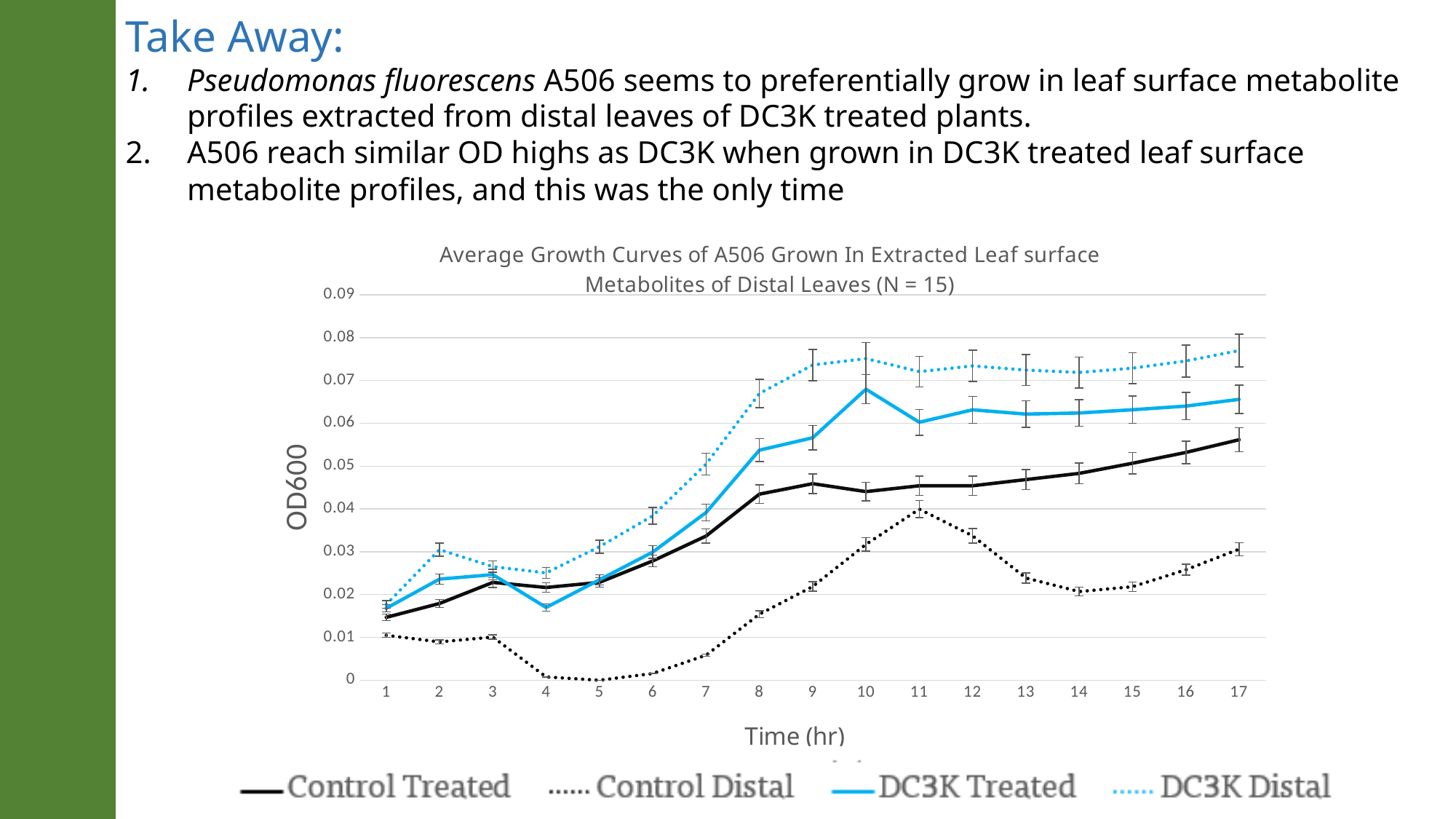
Is the value for Control Distal at hour 5 greater or less than 0.01? less Is the value for Control Treated at hour 17 greater or less than 0.05? greater Is the value for DC3K Distal at hour 10 greater or less than 0.07? greater How many series does the legend list? 4 What is the label of the x axis? Time (hr) Does the Control Distal series rise or fall from hour 11 to hour 14? fall How many time points are plotted along the x axis? 17 What kind of chart is shown on the slide? line chart Which series has the lowest value at hour 17? Control Distal What is the label of the y axis? OD600 At hour 4, which is larger: Control Treated or DC3K Treated? Control Treated Which series has the highest value at hour 17? DC3K Distal